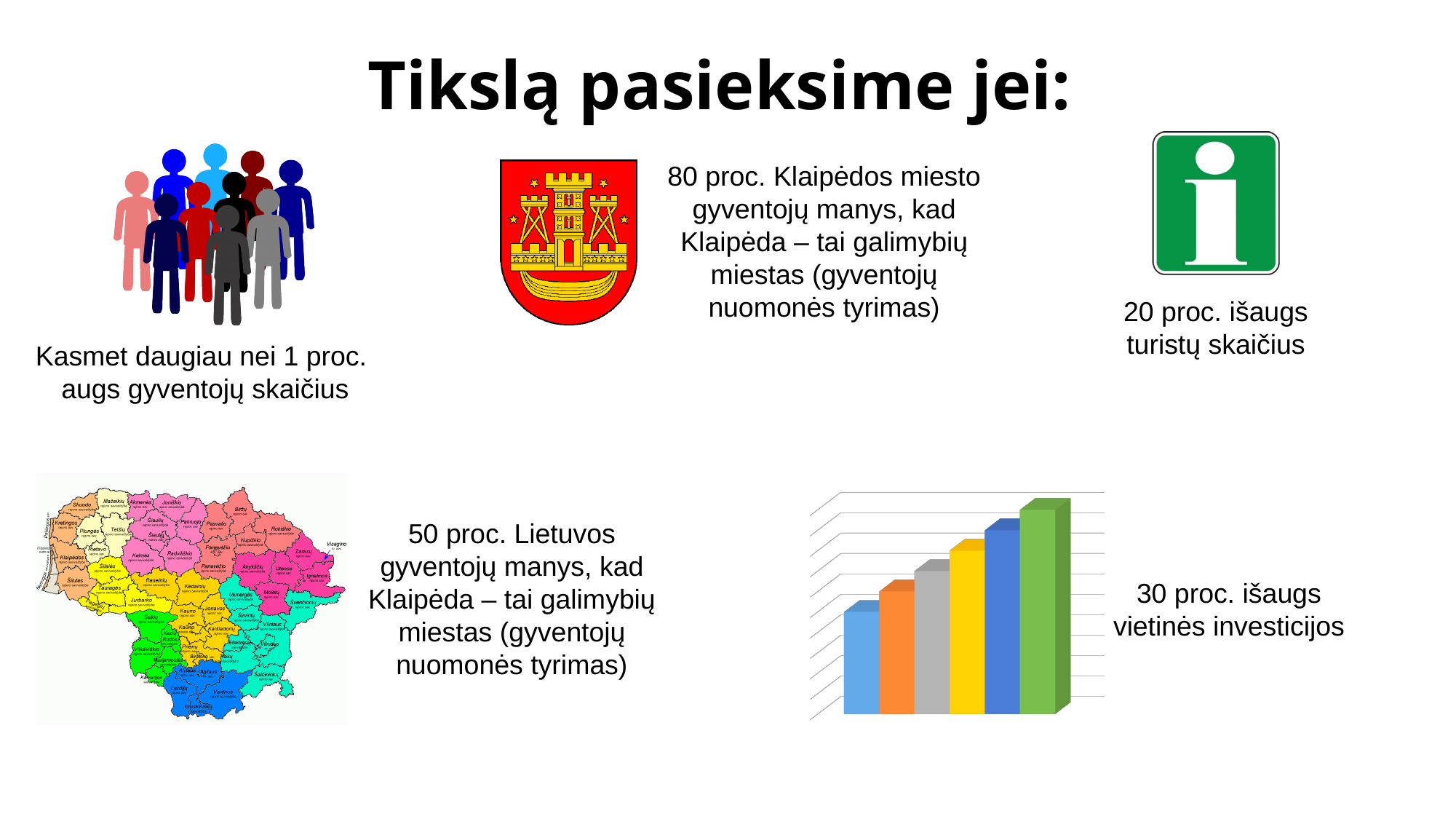
What colour is the tallest bar in the chart in the lower right of the slide? green Does the chart in the lower right of the slide show a legend? no In the chart in the lower right of the slide, which is taller: the orange bar or the dark blue bar? the dark blue bar In the chart in the lower right of the slide, which bar is the shortest: the leftmost or the rightmost? the leftmost In the chart in the lower right of the slide, which is taller: the grey bar or the yellow bar? the yellow bar How many bars does the chart in the lower right of the slide have? 6 What kind of chart is shown in the lower right of the slide? bar chart Do the bars in the chart in the lower right of the slide rise or fall from left to right? rise In the chart in the lower right of the slide, which bar is the tallest: the leftmost or the rightmost? the rightmost